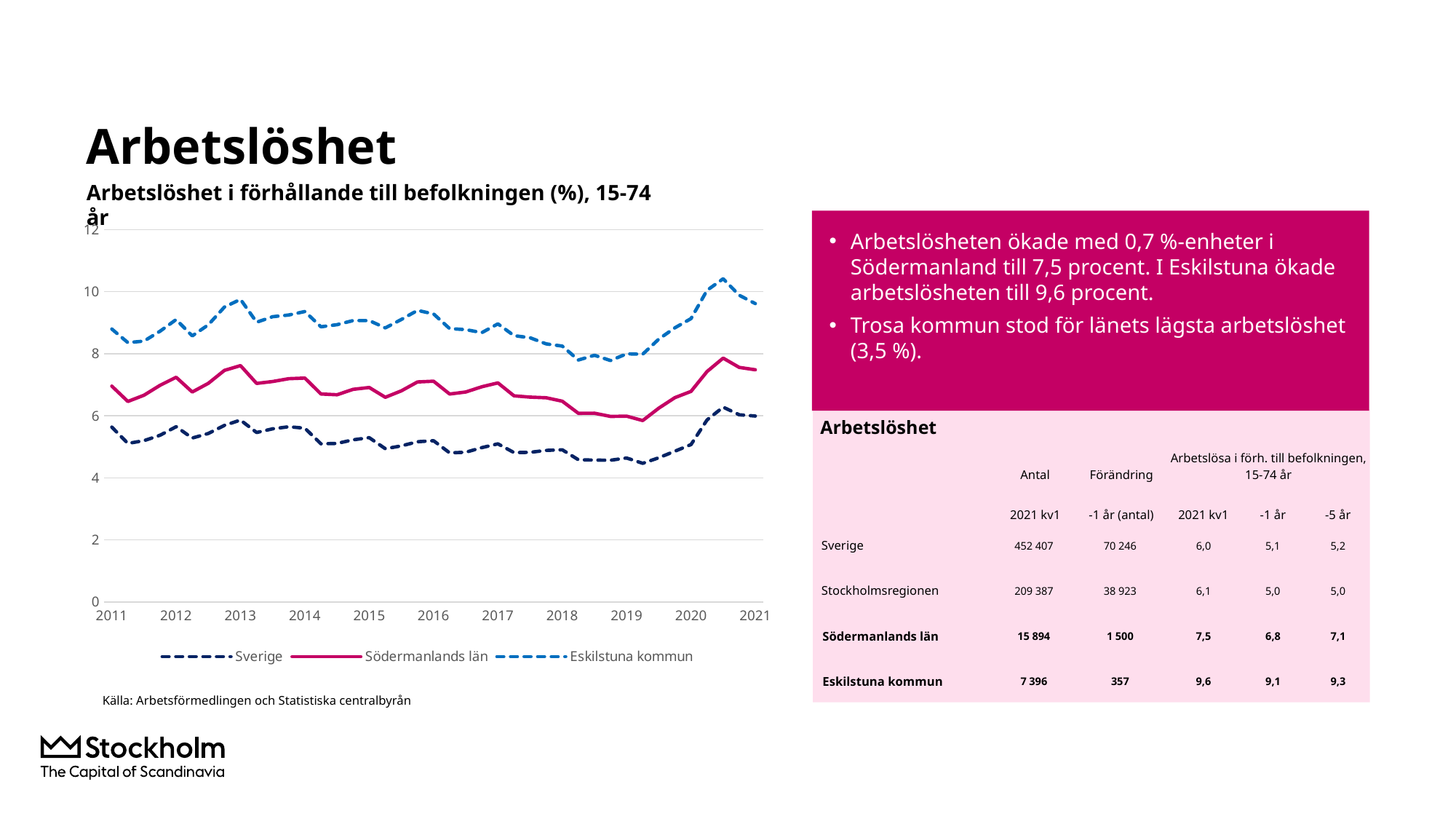
In 2021, which is larger: the value for Eskilstuna kommun or the value for Sverige? Eskilstuna kommun How many years are labelled on the x axis of the chart? 11 Does the Eskilstuna kommun line rise or fall between 2019 and 2020? rise Which series has the lowest values across the whole chart? Sverige What kind of chart is shown on the slide? line chart Is the value for Eskilstuna kommun in 2011 greater or less than 8? greater Is the value for Sverige in 2019 greater or less than 6? less How many series does the chart legend list? 3 Which series are listed in the chart legend? Sverige, Södermanlands län, Eskilstuna kommun What is the title of the chart? Arbetslöshet i förhållande till befolkningen (%), 15-74 år Which series has the highest values across the whole chart? Eskilstuna kommun Is the peak value for Eskilstuna kommun in 2020 greater or less than 10? greater